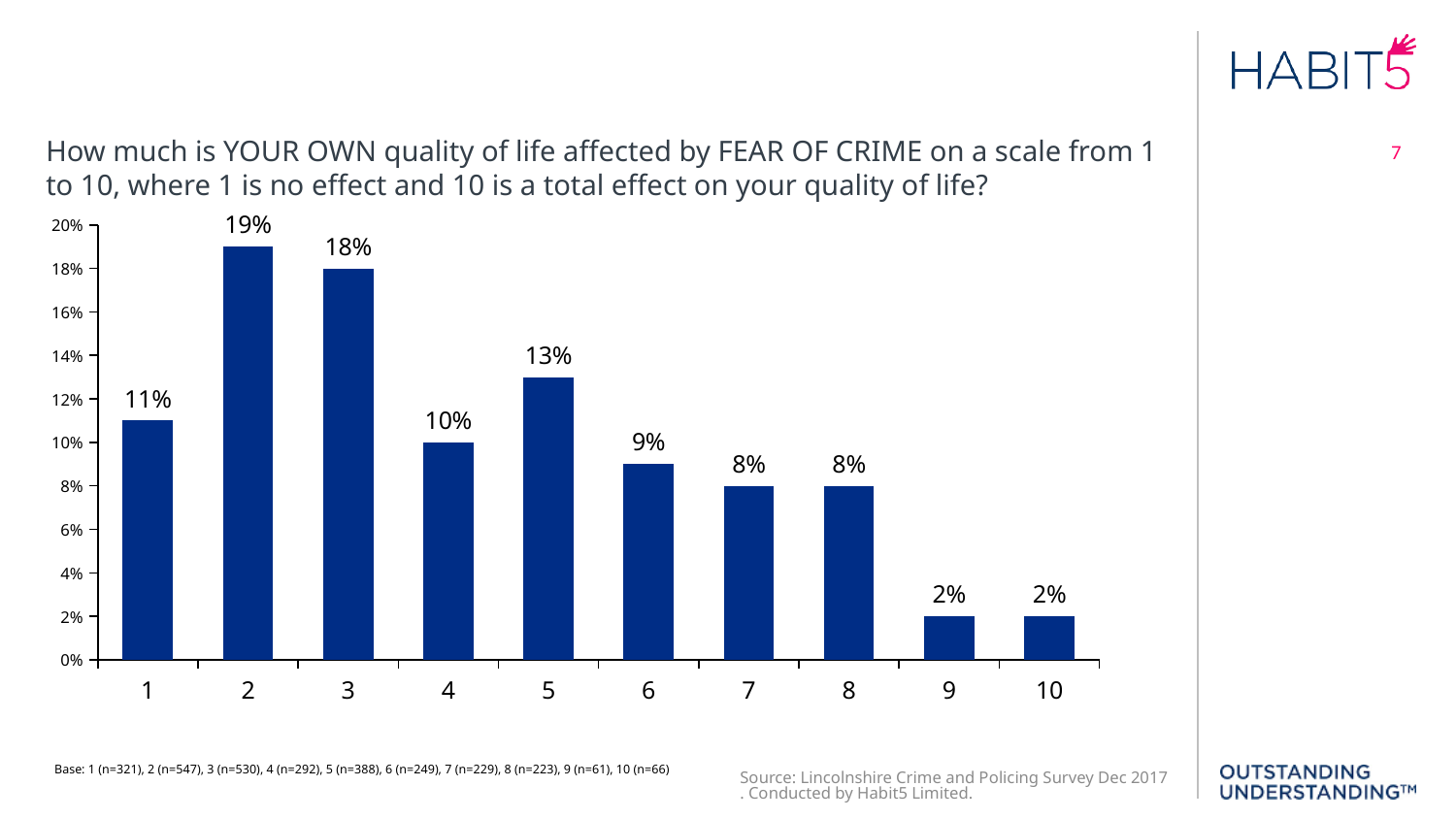
What kind of chart is shown on the slide? Bar chart What percentage of respondents gave a rating of 2? 19% Which rating on the scale has the highest percentage of respondents? 2 What is the combined percentage for ratings 9 and 10? 4% Which has a larger percentage, rating 4 or rating 5? 5 Which has a larger percentage, rating 6 or rating 9? 6 What is the difference in percentage points between ratings 1 and 4? 1% What percentage of respondents gave a rating of 5? 13% Do the percentages generally rise or fall from rating 5 to rating 10? Fall What is the difference in percentage points between ratings 2 and 3? 1% What percentage of respondents gave a rating of 1? 11% How many rating categories are shown on the x axis? 10